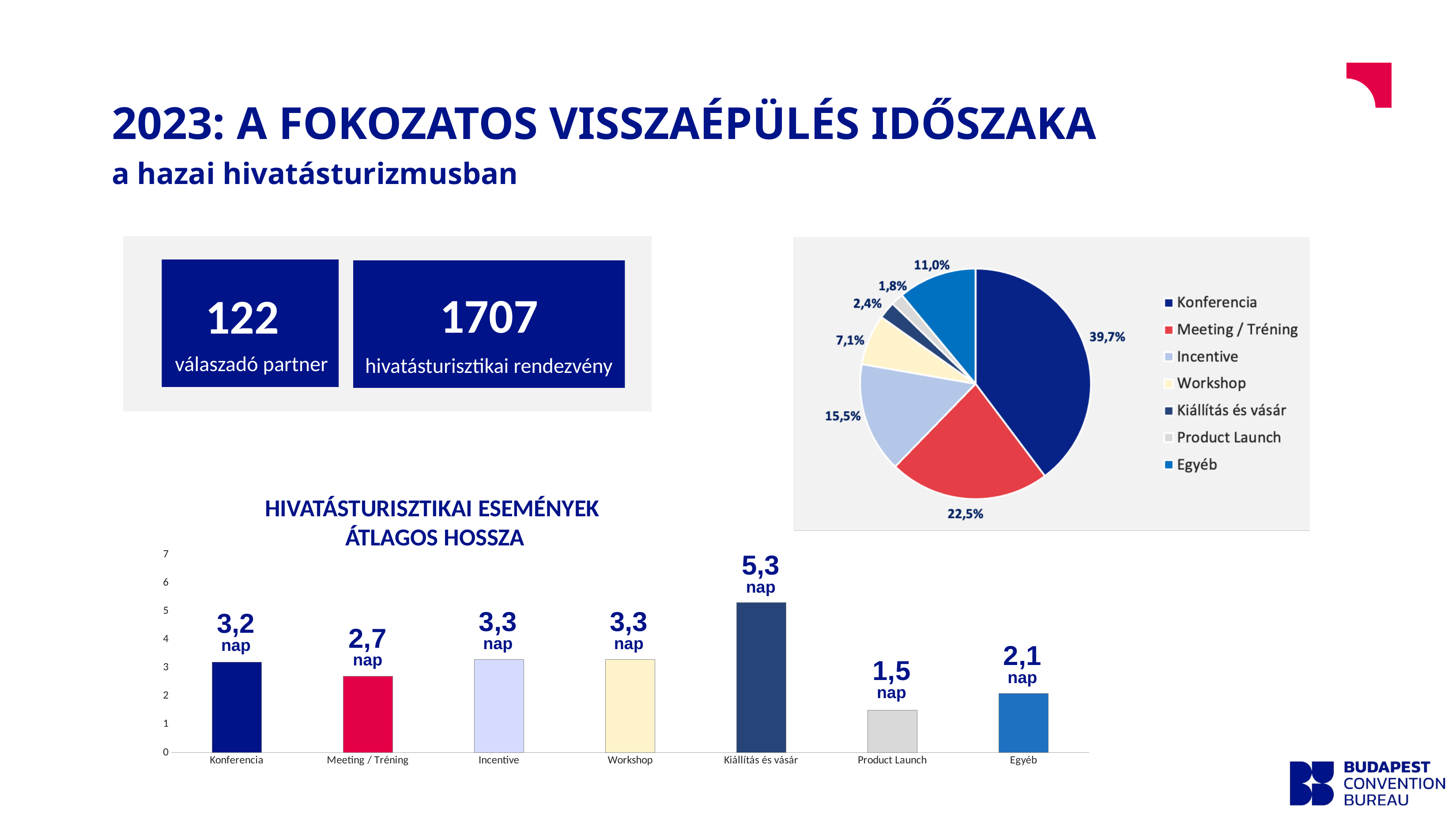
In the chart 'HIVATÁSTURISZTIKAI ESEMÉNYEK ÁTLAGOS HOSSZA', which is larger, Konferencia or Meeting / Tréning? Konferencia In the pie chart on the top right, how many categories does the legend list? 7 In the pie chart on the top right, which category has the smallest slice? Product Launch In the chart 'HIVATÁSTURISZTIKAI ESEMÉNYEK ÁTLAGOS HOSSZA', which category has the lowest value? Product Launch In the chart 'HIVATÁSTURISZTIKAI ESEMÉNYEK ÁTLAGOS HOSSZA', what is the value for Kiállítás és vásár? 5,3 nap In the chart 'HIVATÁSTURISZTIKAI ESEMÉNYEK ÁTLAGOS HOSSZA', what is the difference between Kiállítás és vásár and Egyéb? 3,2 nap In the pie chart on the top right, what share does Meeting / Tréning have? 22,5% In the pie chart on the top right, what is the difference between the Incentive share and the Egyéb share? 4,5% In the pie chart on the top right, which category has the largest slice? Konferencia In the chart 'HIVATÁSTURISZTIKAI ESEMÉNYEK ÁTLAGOS HOSSZA', what is the value for Product Launch? 1,5 nap In the pie chart on the top right, what share does Konferencia have? 39,7% What kind of chart is 'HIVATÁSTURISZTIKAI ESEMÉNYEK ÁTLAGOS HOSSZA'? Bar chart